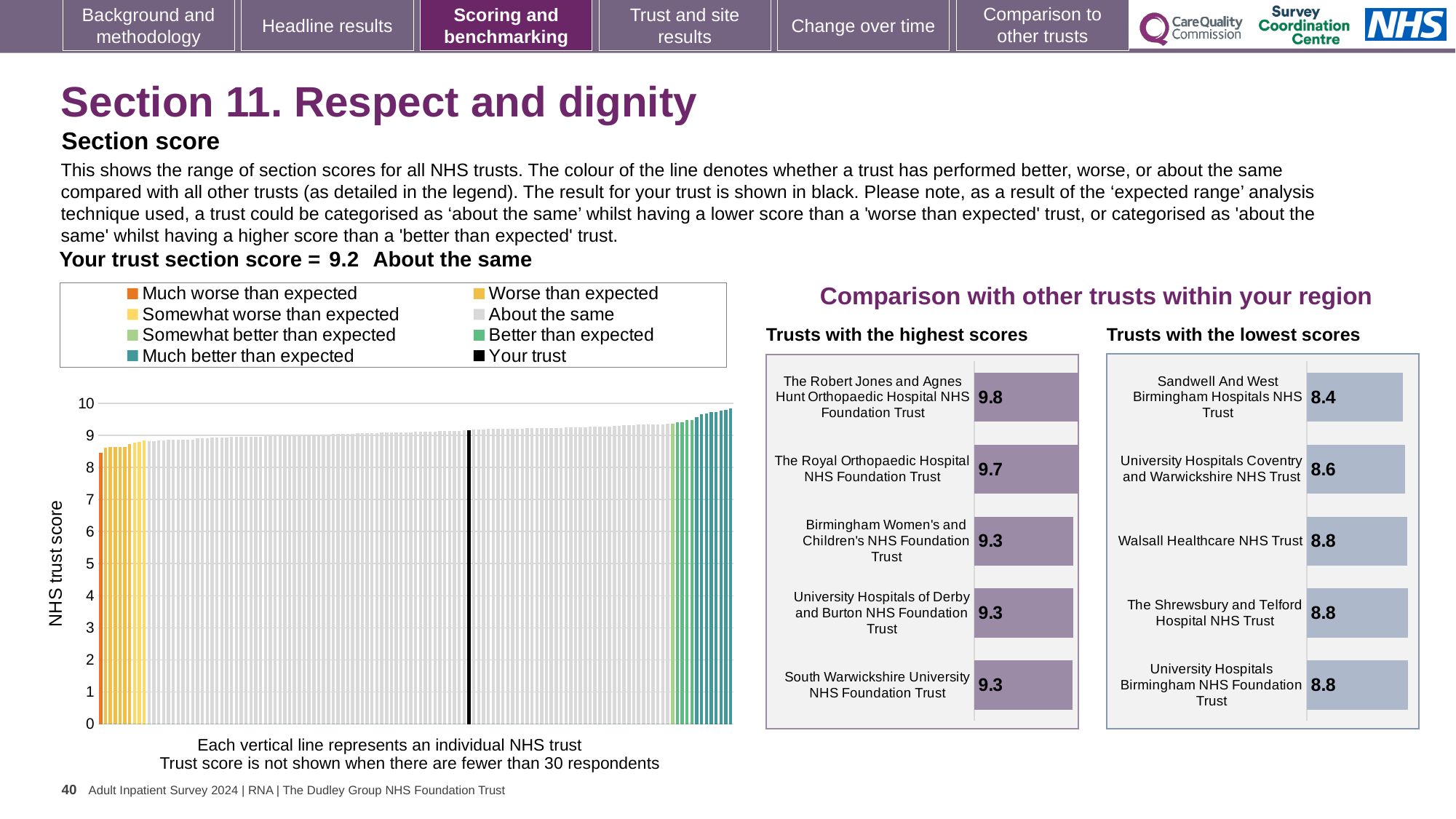
In the 'Trusts with the highest scores' chart, which trust has the highest score? The Robert Jones and Agnes Hunt Orthopaedic Hospital NHS Foundation Trust In the large chart on the left, is the value of the lowest bar greater or less than 9? less In the 'Trusts with the lowest scores' chart, what is the score for Walsall Healthcare NHS Trust? 8.8 In the 'Trusts with the highest scores' chart, what is the difference between the scores of The Robert Jones and Agnes Hunt Orthopaedic Hospital NHS Foundation Trust and South Warwickshire University NHS Foundation Trust? 0.5 In the large chart on the left, how many entries does the legend list? 8 In the 'Trusts with the highest scores' chart, what is the score for The Royal Orthopaedic Hospital NHS Foundation Trust? 9.7 What is the section score for your trust shown on the slide? 9.2 In the large chart on the left, do the trust scores rise or fall from left to right? rise How many trusts are listed in the 'Trusts with the highest scores' chart? 5 In the 'Trusts with the lowest scores' chart, which trust has the lowest score? Sandwell And West Birmingham Hospitals NHS Trust In the 'Trusts with the lowest scores' chart, which has the larger score: University Hospitals Coventry and Warwickshire NHS Trust or Sandwell And West Birmingham Hospitals NHS Trust? University Hospitals Coventry and Warwickshire NHS Trust What kind of chart is the large chart on the left showing NHS trust scores? bar chart